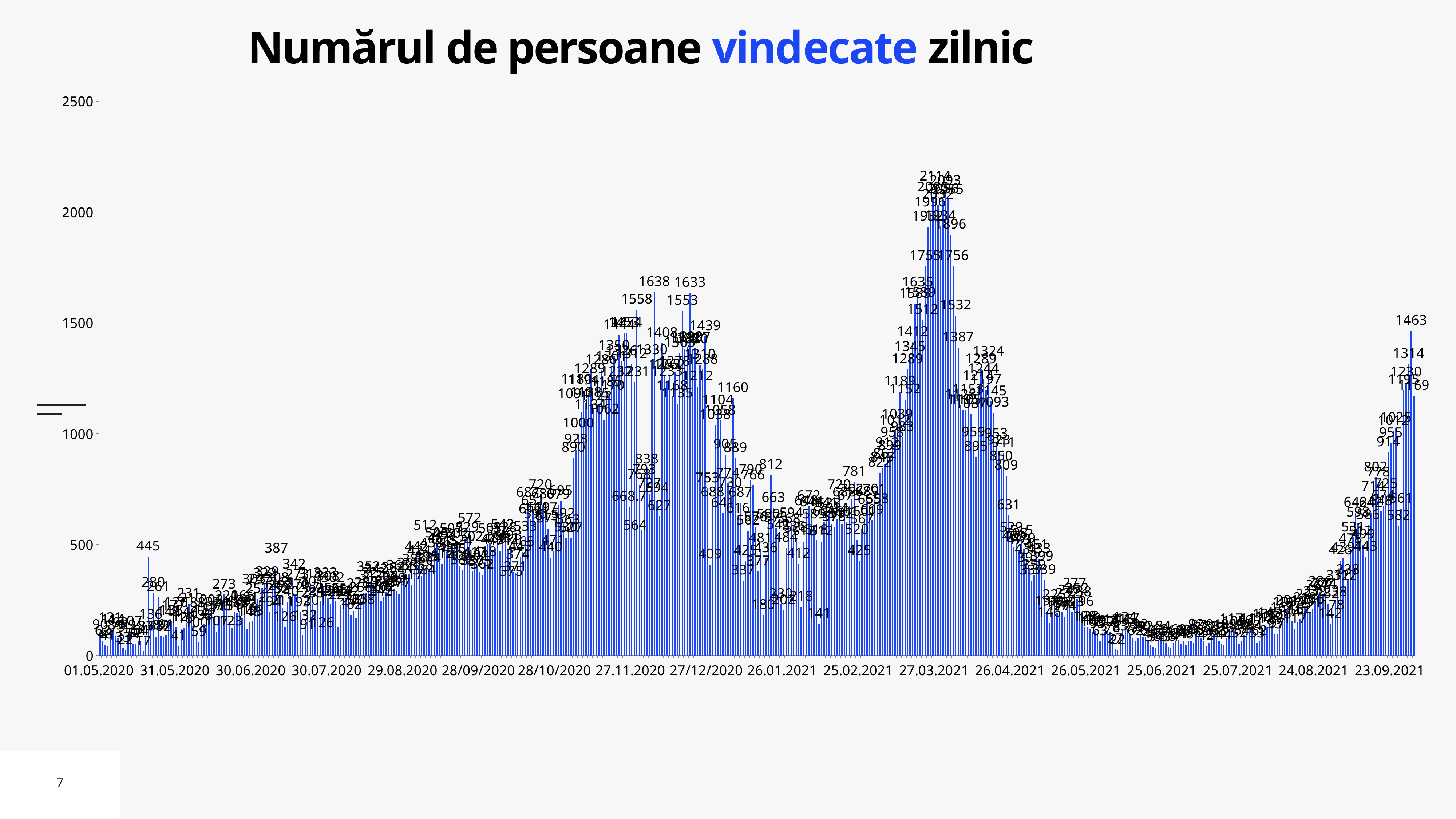
What is the highest value labelled in the rise near 23.09.2021? 1463 What kind of chart is shown on the slide? bar chart What is the maximum value shown on the vertical axis? 2500 What is the difference between the highest labelled value (2114) and the highest value near 23.09.2021 (1463)? 651 How many date labels are shown on the horizontal axis? 18 Is the tallest bar on the chart greater or less than 2000? greater What is the value of the tall spike shortly before 31.05.2020? 445 Is the value for 01.05.2020 greater or less than 500? less Which peak is higher: the one around 27.03.2021 or the one around 27.11.2020? the one around 27.03.2021 What is the title of the chart? Numărul de persoane vindecate zilnic Do the values rise or fall between 24.08.2021 and 23.09.2021? rise What is the highest daily value labelled on the chart? 2114